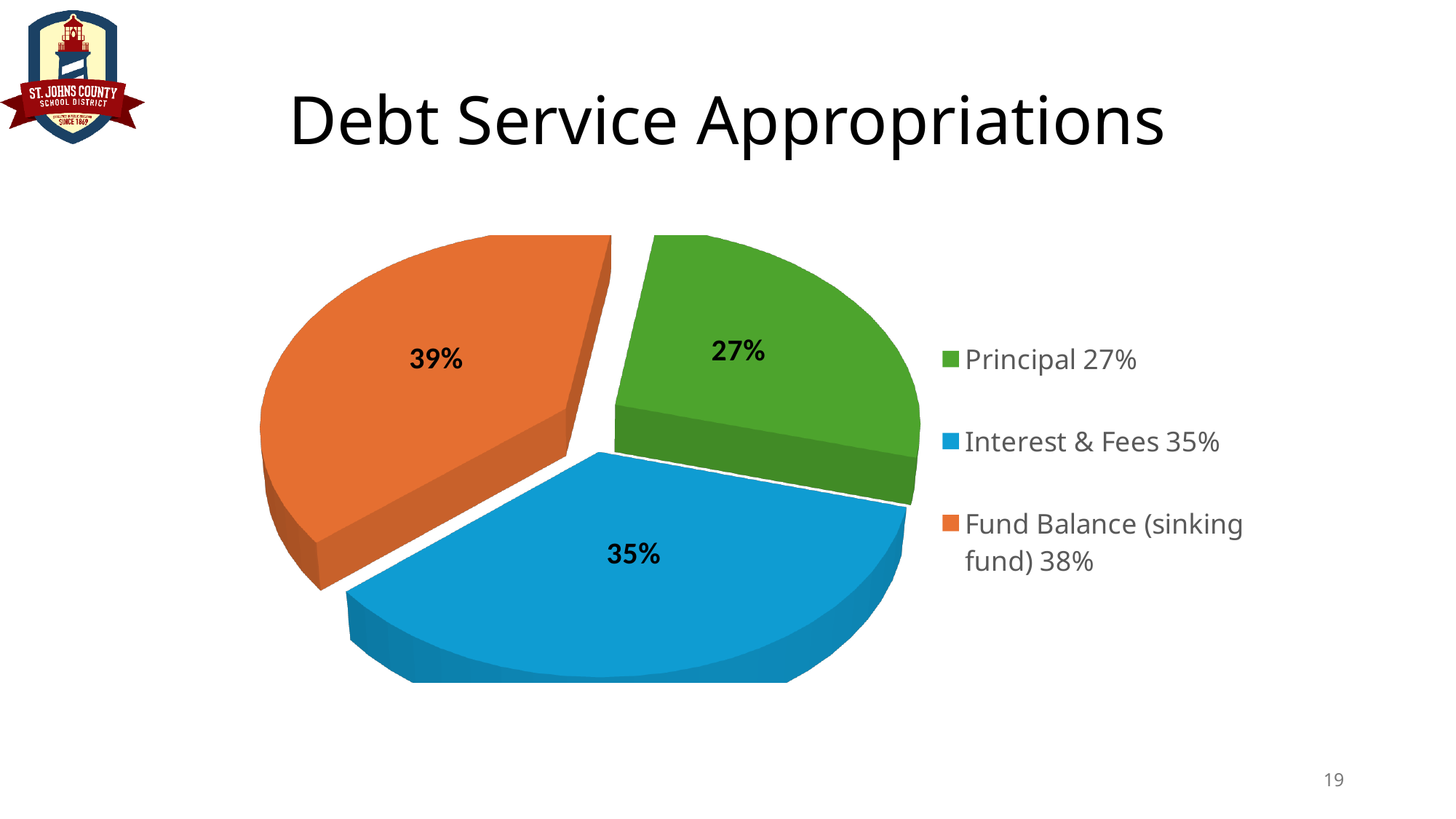
What share of the pie is labelled for Interest & Fees? 35% Which category has the largest slice of the pie? Fund Balance (sinking fund) What is the title of the chart on the slide? Debt Service Appropriations How many slices does the pie chart have? 3 What type of chart is shown on the slide? Pie chart Which is larger, the Interest & Fees slice or the Principal slice? Interest & Fees By how many percentage points does Interest & Fees exceed Principal? 8 percentage points What percentage does the legend give for Fund Balance (sinking fund)? 38% Which category has the smallest slice of the pie? Principal What colour is the Interest & Fees slice? Blue What percentage is printed on the orange slice of the pie? 39% What share of the pie is labelled for Principal? 27%